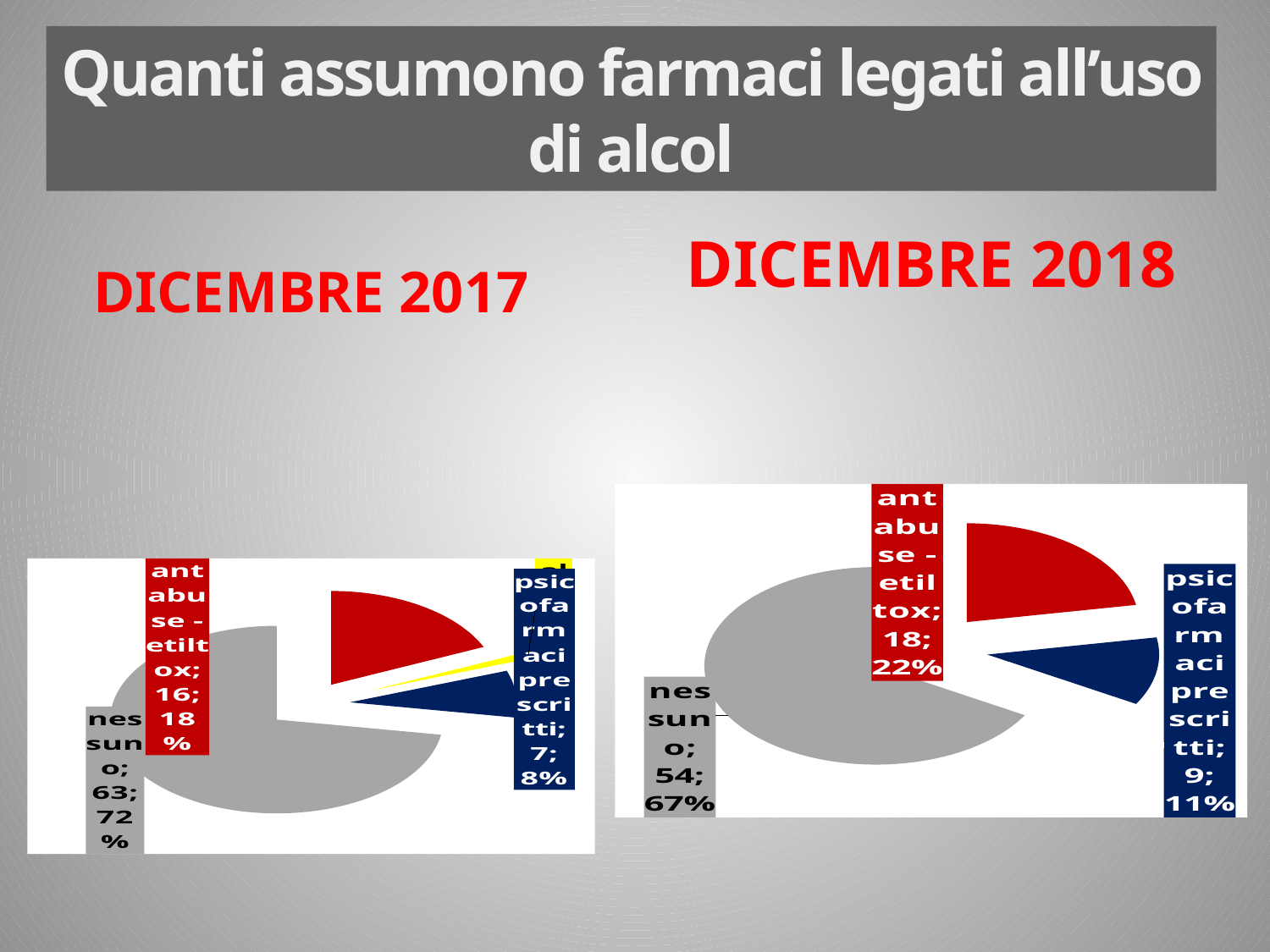
In the DICEMBRE 2018 chart, which category has the largest slice? nessuno In the DICEMBRE 2017 chart, which is larger: 'antabuse - etiltox' or 'psicofarmaci prescritti'? antabuse - etiltox In the DICEMBRE 2018 chart, what percentage is shown for 'nessuno'? 67% In the DICEMBRE 2018 chart, how many people are in the 'antabuse - etiltox' category? 18 In the DICEMBRE 2018 chart, what percentage is shown for 'psicofarmaci prescritti'? 11% In the DICEMBRE 2017 chart, how many people are in the 'psicofarmaci prescritti' category? 7 In the DICEMBRE 2017 chart, what is the value for 'nessuno'? 63; 72% In the DICEMBRE 2018 chart, what is the difference between the counts for 'nessuno' and 'antabuse - etiltox'? 36 In the DICEMBRE 2018 chart, which category has the smallest slice? psicofarmaci prescritti What type of chart is used for DICEMBRE 2018? pie chart In the DICEMBRE 2017 chart, what percentage is shown for 'antabuse - etiltox'? 18% How many slices does the DICEMBRE 2018 pie chart have? 3